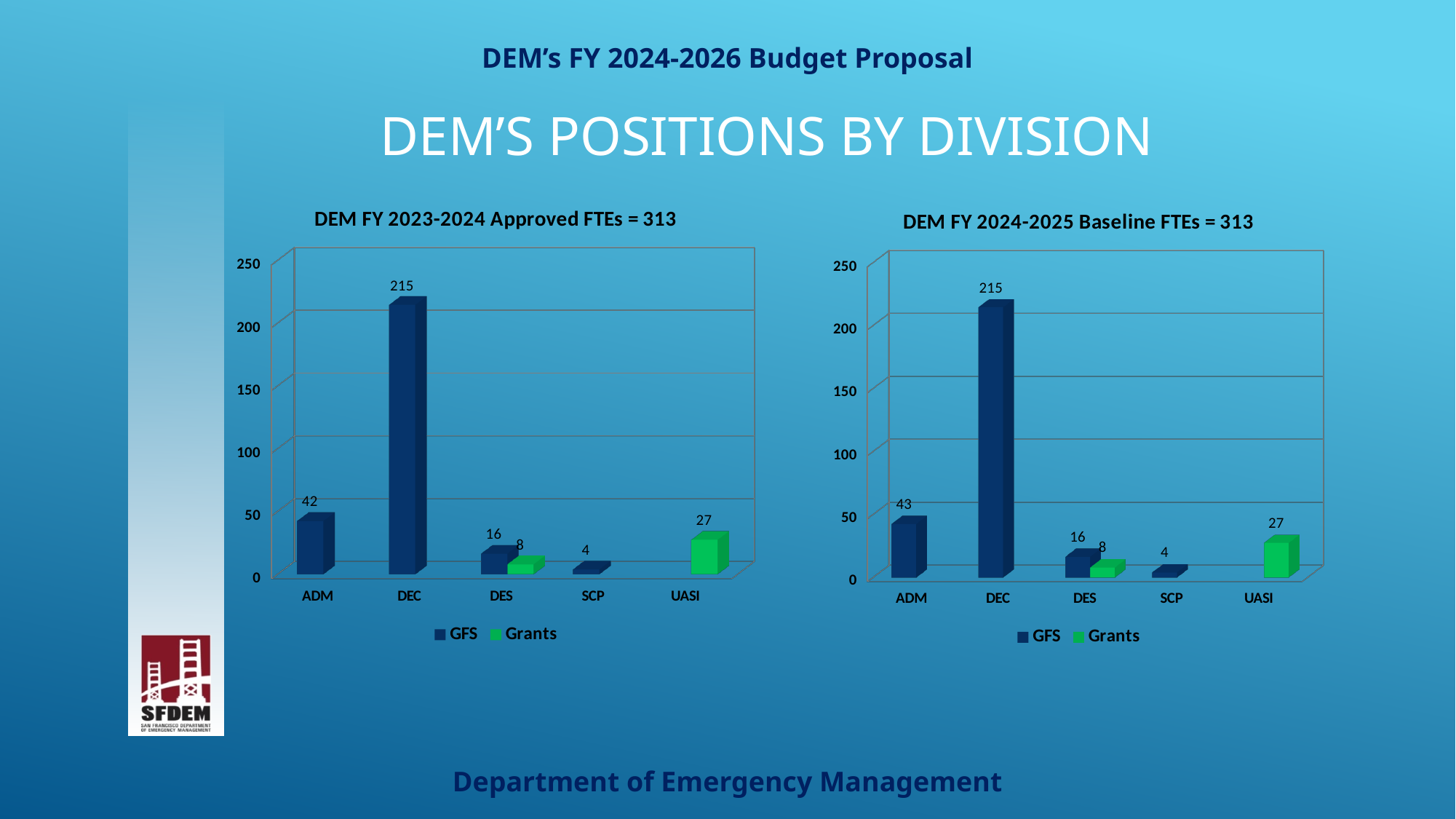
In the 'DEM FY 2023-2024 Approved FTEs = 313' chart, which division has the lowest GFS value? SCP In the 'DEM FY 2024-2025 Baseline FTEs = 313' chart, what is the Grants value for UASI? 27 In the 'DEM FY 2023-2024 Approved FTEs = 313' chart, what is the GFS value for DEC? 215 How many series does the legend of the 'DEM FY 2024-2025 Baseline FTEs = 313' chart list? 2 In the 'DEM FY 2023-2024 Approved FTEs = 313' chart, what is the Grants value for DES? 8 In the 'DEM FY 2023-2024 Approved FTEs = 313' chart, what is the GFS value for ADM? 42 In the 'DEM FY 2024-2025 Baseline FTEs = 313' chart, which is larger: the GFS value for DES or the Grants value for UASI? Grants value for UASI How many divisions are shown on the x axis of the 'DEM FY 2023-2024 Approved FTEs = 313' chart? 5 In the 'DEM FY 2023-2024 Approved FTEs = 313' chart, what is the difference between the GFS values for DEC and ADM? 173 In the 'DEM FY 2024-2025 Baseline FTEs = 313' chart, which division has the highest GFS value? DEC What kind of chart is the 'DEM FY 2023-2024 Approved FTEs = 313' chart? Bar chart In the 'DEM FY 2024-2025 Baseline FTEs = 313' chart, what is the GFS value for ADM? 43